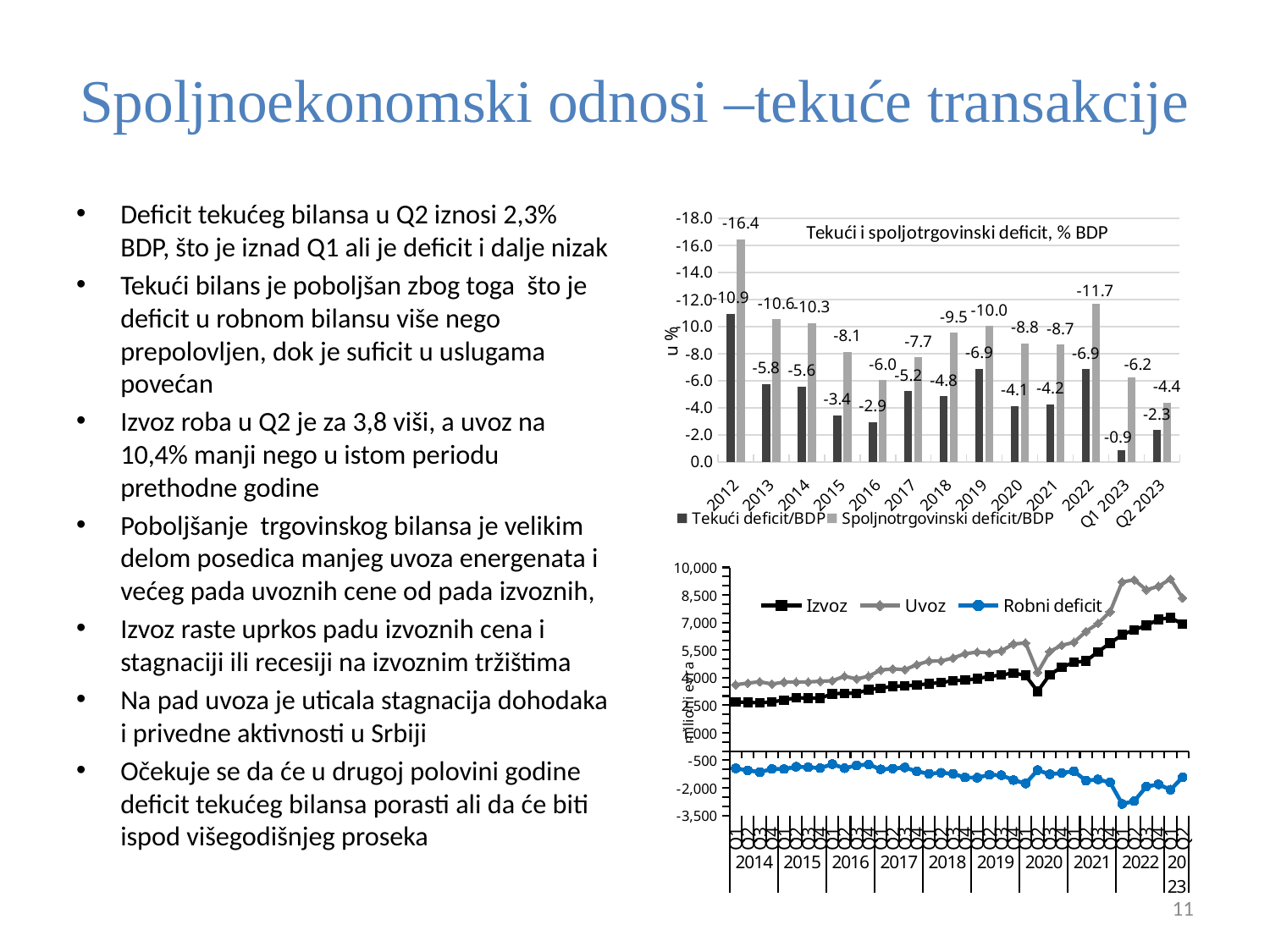
In the top chart, which category has the smallest Tekući deficit/BDP bar? Q1 2023 In the top chart, which is larger in magnitude for 2015: Tekući deficit/BDP or Spoljnotrgovinski deficit/BDP? Spoljnotrgovinski deficit/BDP In the top chart, what is the difference between the Spoljnotrgovinski deficit/BDP and Tekući deficit/BDP values for 2019? 3.1 In the top chart, what is the value of Tekući deficit/BDP for 2012? -10.9 In the top chart, which category has the largest Spoljnotrgovinski deficit/BDP bar? 2012 In the top chart, what is the value of Spoljnotrgovinski deficit/BDP for 2022? -11.7 In the top chart, what is the value of Spoljnotrgovinski deficit/BDP for 2016? -6.0 How many series does the legend of the bottom chart list? 3 How many categories are shown on the x axis of the top chart? 13 In the top chart, what is the value of Tekući deficit/BDP for Q2 2023? -2.3 What type of chart is the bottom chart? Line chart In the bottom chart, does the Izvoz series generally rise or fall from 2014 to 2022? Rise